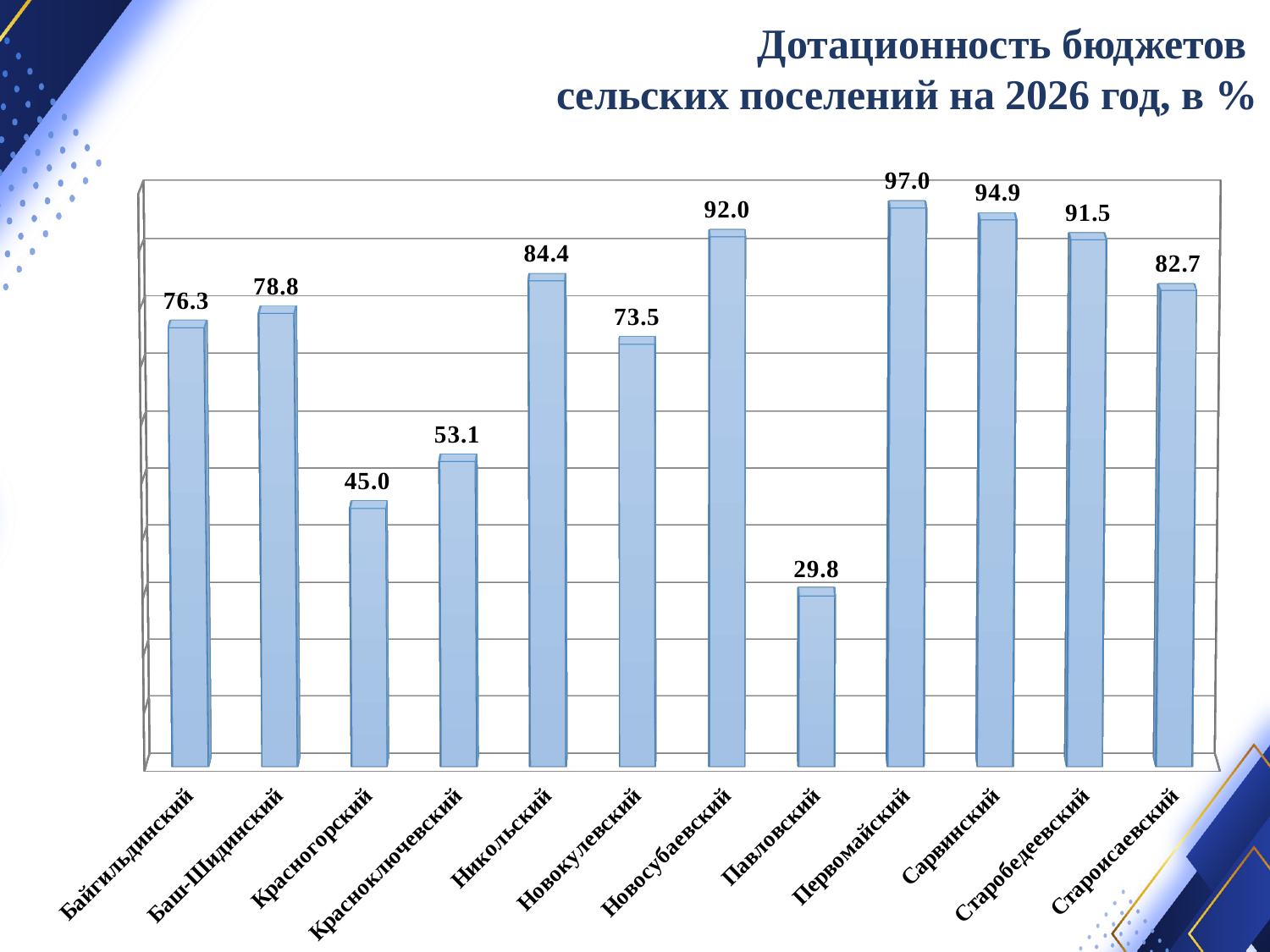
What kind of chart is shown on the slide? bar chart What is the value for Красноключевский? 53.1 What is the value for Новокулевский? 73.5 What is the difference between the values for Баш-Шидинский and Байгильдинский? 2.5 How many categories are shown on the chart? 12 What is the value for Павловский? 29.8 What is the difference between the values for Первомайский and Павловский? 67.2 What is the title of the chart? Дотационность бюджетов сельских поселений на 2026 год, в % Which category has the lowest value? Павловский What is the value for Первомайский? 97.0 Which is larger, the value for Никольский or the value for Староисаевский? Никольский Which category has the highest value? Первомайский